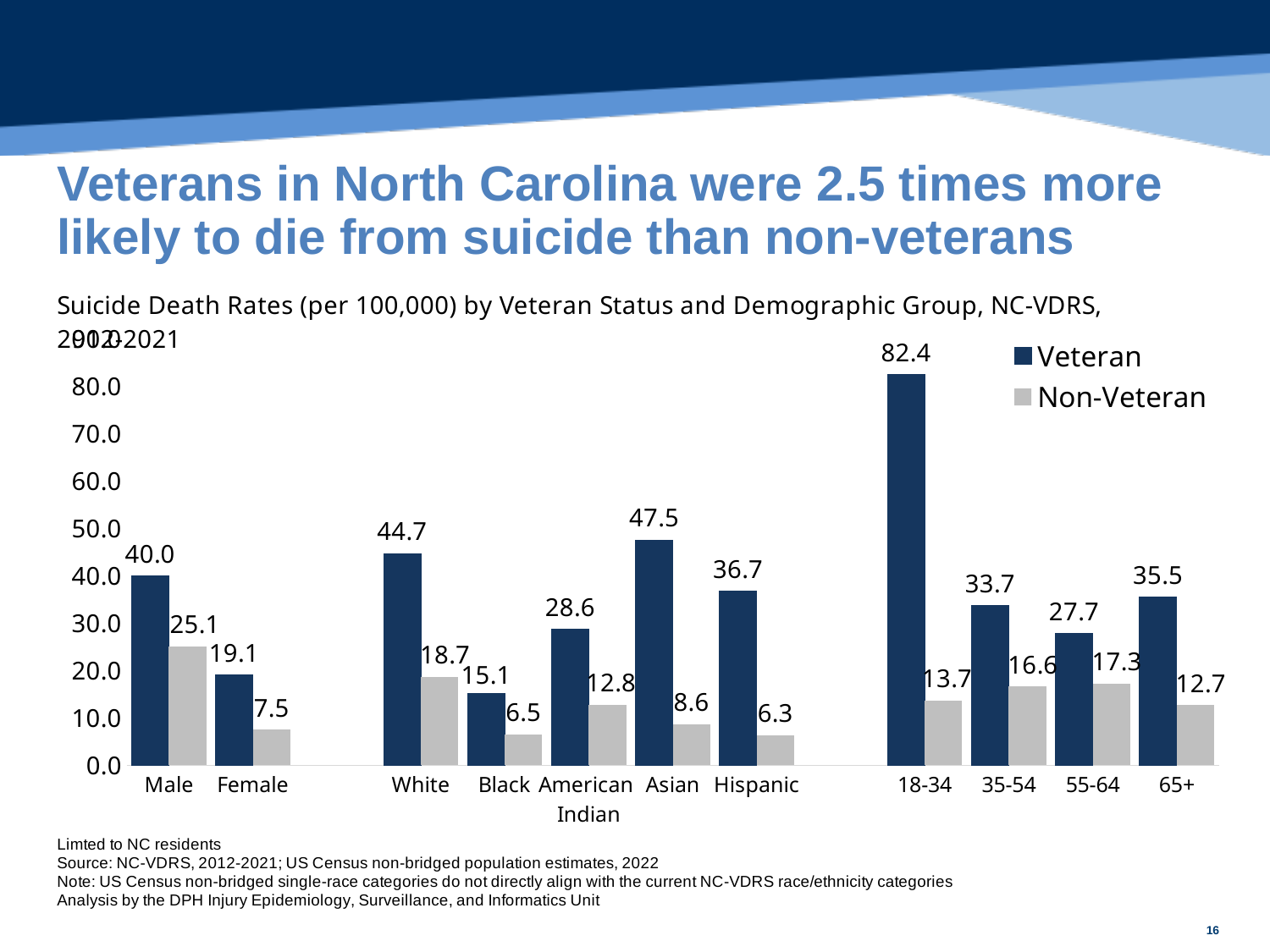
What is the difference between the Veteran and Non-Veteran suicide death rates for Males? 14.9 Is the Veteran suicide death rate for the 35-54 age group greater or less than 30.0? greater How many series does the legend list? 2 How many demographic groups are shown on the x axis of the chart? 11 Which colour represents the Non-Veteran series in the chart? Grey Which demographic group has the lowest Non-Veteran suicide death rate? Hispanic Which demographic group has the highest Veteran suicide death rate? 18-34 What is the Non-Veteran suicide death rate for Females? 7.5 What is the Veteran suicide death rate for Hispanic residents? 36.7 What is the Veteran suicide death rate for the 18-34 age group? 82.4 Which is larger, the Veteran rate for White residents or the Veteran rate for Asian residents? Asian What kind of chart is shown on the slide? Bar chart